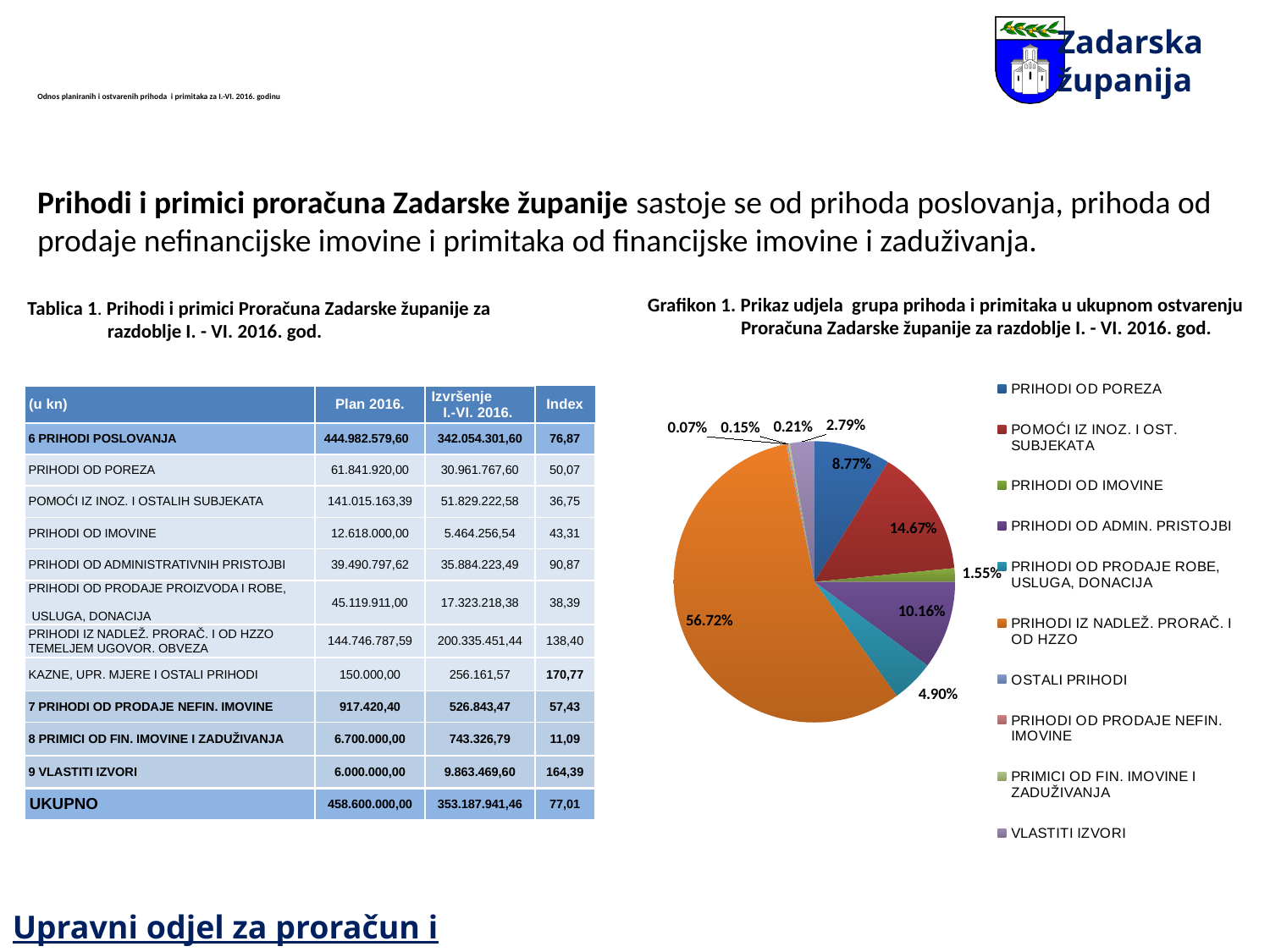
What is the title of the pie chart on the slide? Grafikon 1. Prikaz udjela grupa prihoda i primitaka u ukupnom ostvarenju Proračuna Zadarske županije za razdoblje I. - VI. 2016. god. In Grafikon 1, what is the difference between the share for POMOĆI IZ INOZ. I OST. SUBJEKATA and the share for PRIHODI OD POREZA? 5.90% In Grafikon 1, what is the share for PRIHODI OD ADMIN. PRISTOJBI? 10.16% In Grafikon 1, what is the share for PRIHODI OD POREZA? 8.77% In Grafikon 1, which is larger: the share for POMOĆI IZ INOZ. I OST. SUBJEKATA or the share for PRIHODI OD ADMIN. PRISTOJBI? POMOĆI IZ INOZ. I OST. SUBJEKATA In Grafikon 1, which category has the largest share of the pie? PRIHODI IZ NADLEŽ. PRORAČ. I OD HZZO In Grafikon 1, what is the share for VLASTITI IZVORI? 2.79% In Grafikon 1, what is the share for POMOĆI IZ INOZ. I OST. SUBJEKATA? 14.67% In Grafikon 1, what share does PRIHODI IZ NADLEŽ. PRORAČ. I OD HZZO have? 56.72% How many entries does the legend of Grafikon 1 list? 10 In Grafikon 1, which category has the smallest share? OSTALI PRIHODI What kind of chart is Grafikon 1? pie chart